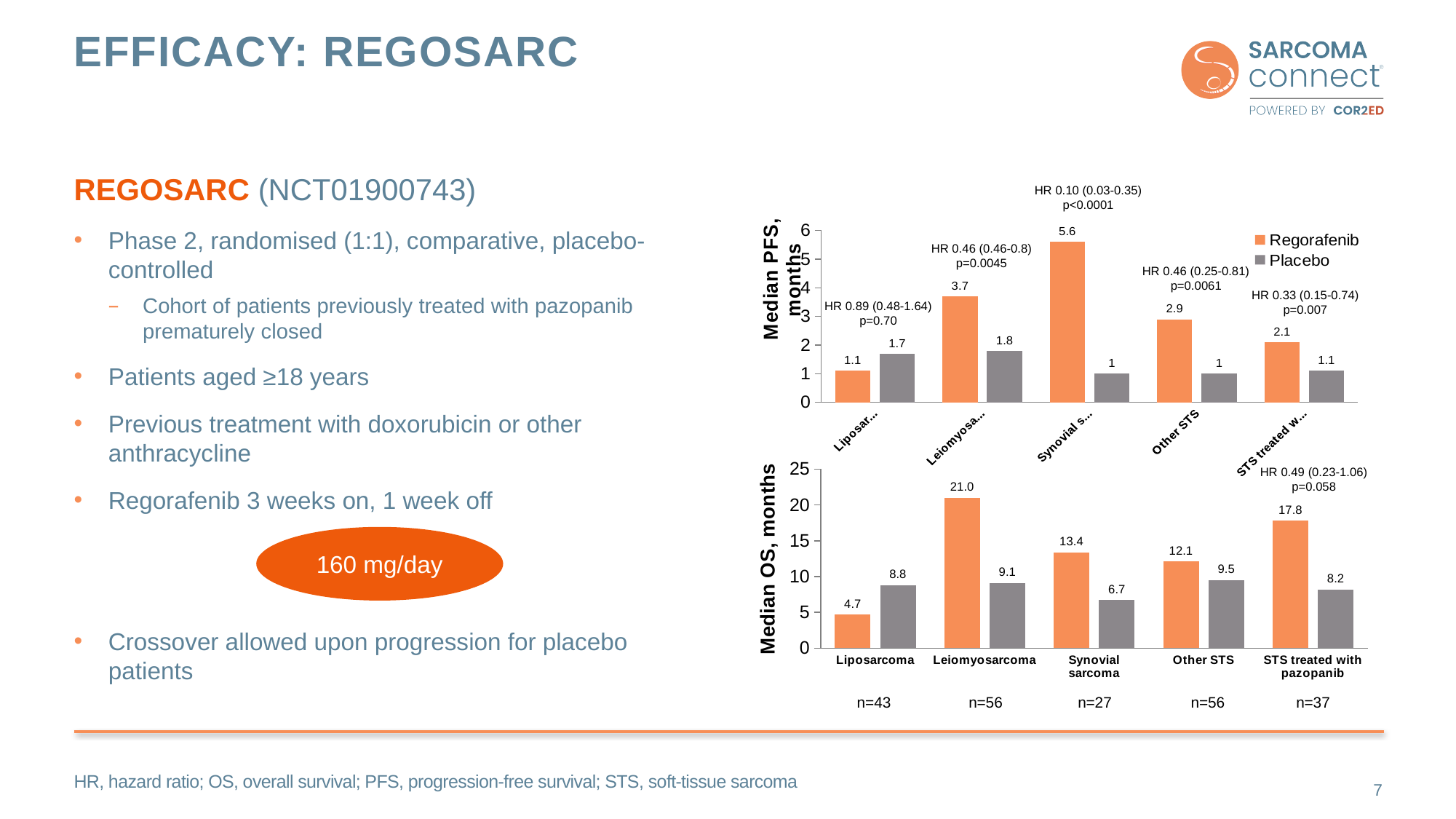
In the Median OS chart (bottom), which category has the highest Regorafenib value? Leiomyosarcoma How many categories are shown on the x axis of the Median OS chart (bottom)? 5 In the Median OS chart (bottom), which category has the lowest Regorafenib value? Liposarcoma In the Median PFS chart (top), what is the median PFS for Regorafenib in Other STS? 2.9 In the Median OS chart (bottom), what is the difference between the Regorafenib and Placebo values for STS treated with pazopanib? 9.6 In the Median OS chart (bottom), what is the median OS for Placebo in Synovial sarcoma? 6.7 What type of chart is the Median OS chart (bottom)? Bar chart In the Median OS chart (bottom), which is larger for Liposarcoma: Regorafenib or Placebo? Placebo In the Median PFS chart (top), what is the median PFS for Placebo in Other STS? 1 In the Median OS chart (bottom), what is the median OS for Regorafenib in Leiomyosarcoma? 21.0 How many series does the legend of the Median PFS chart (top) list? 2 In the Median PFS chart (top), is the highest Regorafenib value greater or less than 5? greater